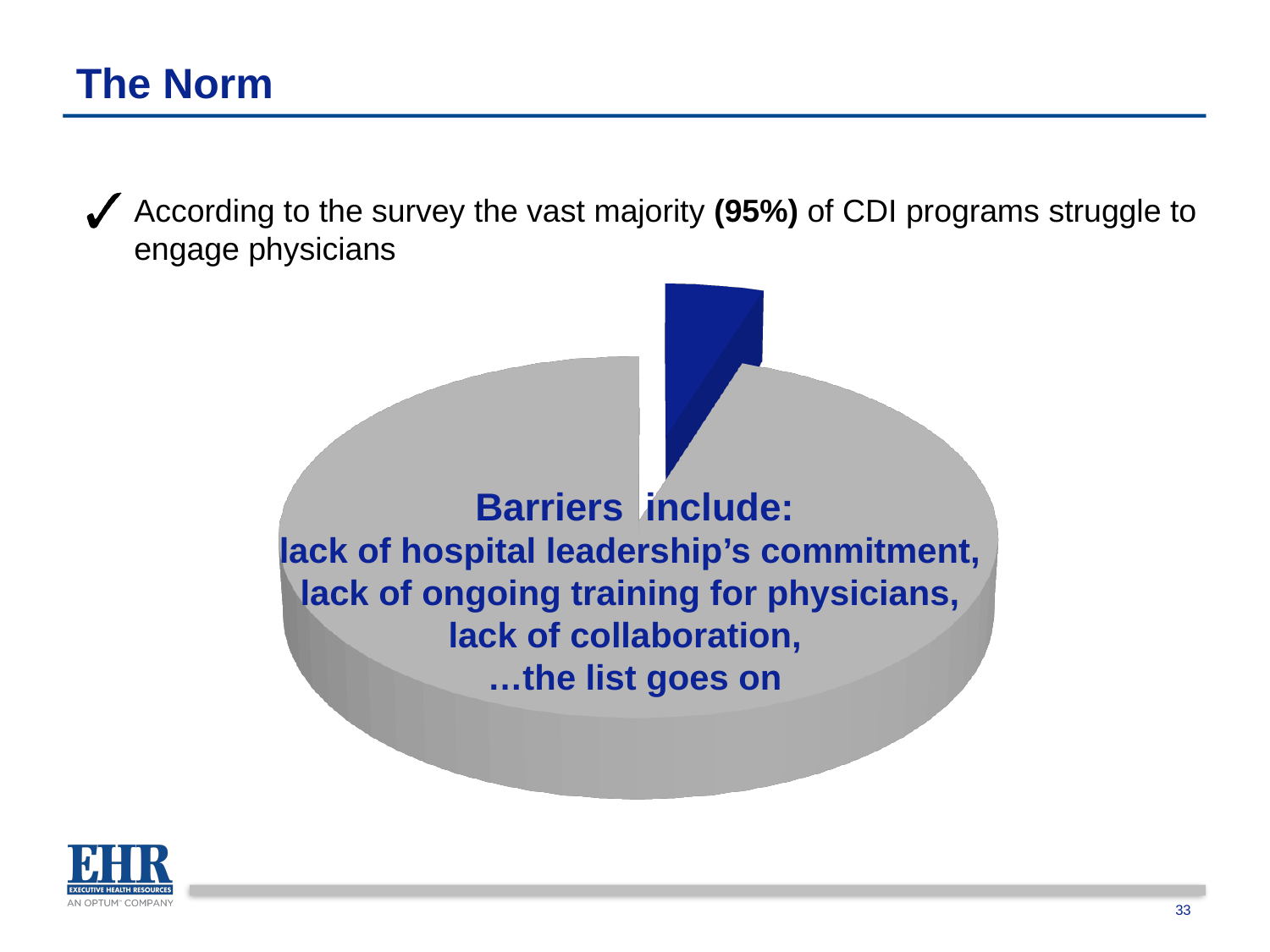
Which slice of the pie chart is the smallest? the blue slice How many slices does the pie chart have? 2 Which slice of the pie chart is larger, the gray slice or the blue slice? the gray slice What is the first line of the bold text printed over the pie chart? Barriers include: What kind of chart is shown on the slide? pie chart What colour is the small slice that is pulled out from the pie chart? blue Does the pie chart have a legend? No According to the slide text, what percentage of CDI programs struggle to engage physicians? 95%